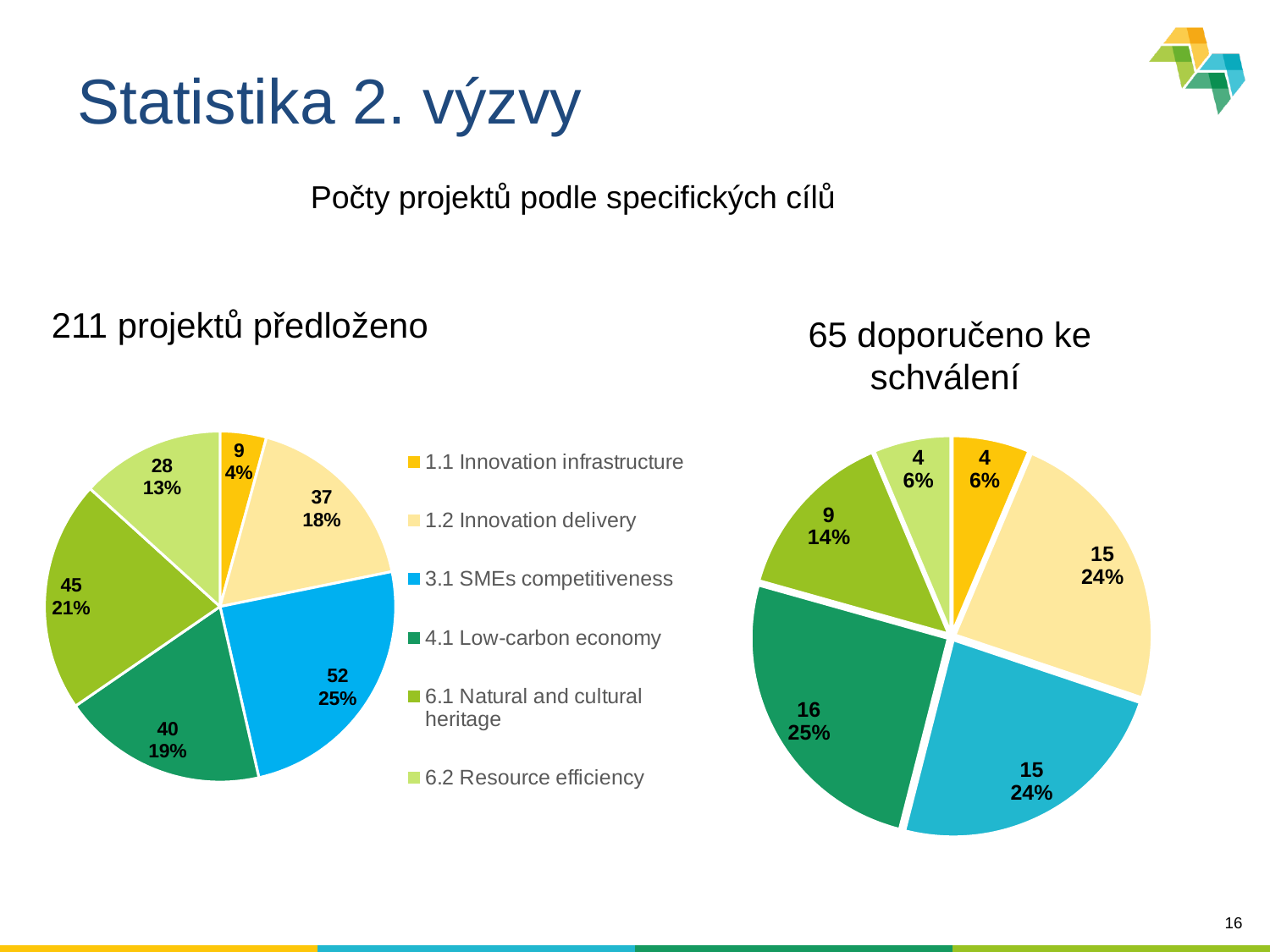
In the '65 doporučeno ke schválení' chart, which category has the largest slice? 4.1 Low-carbon economy How many categories does the legend list? 6 In the '65 doporučeno ke schválení' chart, which is larger: 1.2 Innovation delivery or 6.1 Natural and cultural heritage? 1.2 Innovation delivery Which colour represents 3.1 SMEs competitiveness in the legend? Blue In the '211 projektů předloženo' chart, what is the difference between the number of projects in 4.1 Low-carbon economy and 6.2 Resource efficiency? 12 In the '211 projektů předloženo' chart, how many projects are in 3.1 SMEs competitiveness? 52 What type of chart is used on this slide? Pie chart In the '211 projektů předloženo' chart, what share of the pie is 6.1 Natural and cultural heritage? 21% In the '65 doporučeno ke schválení' chart, what share of the pie is 6.1 Natural and cultural heritage? 14% In the '65 doporučeno ke schválení' chart, how many projects are in 4.1 Low-carbon economy? 16 In the '211 projektů předloženo' chart, which category has the largest slice? 3.1 SMEs competitiveness In the '211 projektů předloženo' chart, which category has the smallest slice? 1.1 Innovation infrastructure